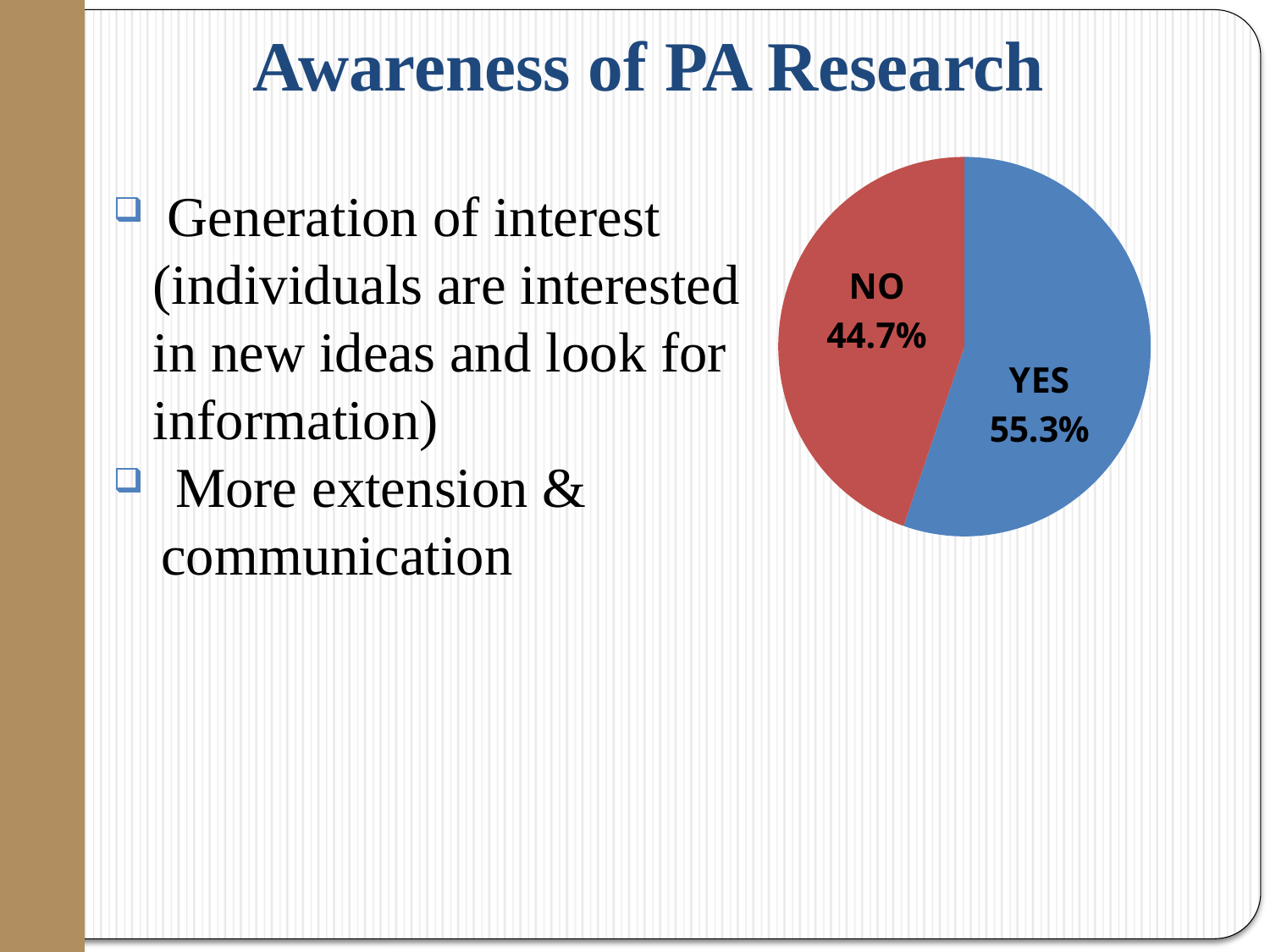
What kind of chart is shown on the slide? pie chart Is the NO slice greater or less than 50%? less What percentage of the pie is labelled YES? 55.3% Is the YES slice greater or less than 50%? greater What colour is the NO slice of the pie? red What percentage of the pie is labelled NO? 44.7% Which slice of the pie is the largest? YES What colour is the YES slice of the pie? blue How many slices does the pie chart have? 2 What is the difference in percentage points between the YES and NO slices? 10.6 Which is larger, the YES slice or the NO slice? YES Which slice of the pie is the smallest? NO